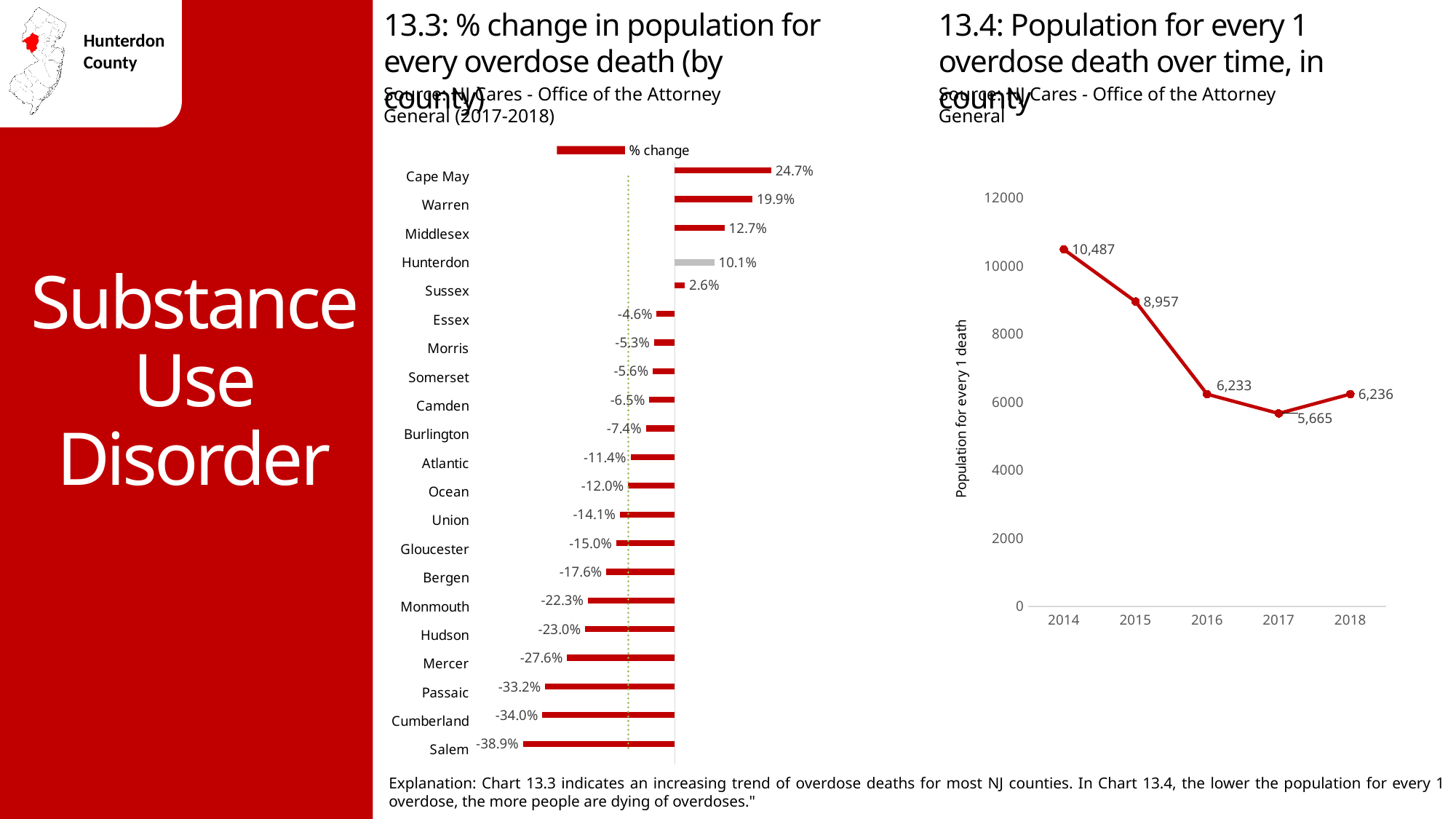
In chart 13.3, what is the % change for Salem? -38.9% In chart 13.3, which county has the highest % change? Cape May In chart 13.3, what is the % change for Hunterdon? 10.1% In chart 13.3, how many counties are shown? 21 In chart 13.3, what is the % change for Cape May? 24.7% In chart 13.3, which has a larger % change, Mercer or Passaic? Mercer In chart 13.4, what is the difference between the 2014 and 2018 values? 4,251 In chart 13.4, which year has the lowest population for every 1 overdose death? 2017 In chart 13.3, which county has the lowest % change? Salem In chart 13.3, what is the difference between the % change for Warren and Middlesex? 7.2 percentage points What kind of chart is chart 13.4? Line chart In chart 13.4, what is the population for every 1 overdose death in 2014? 10,487